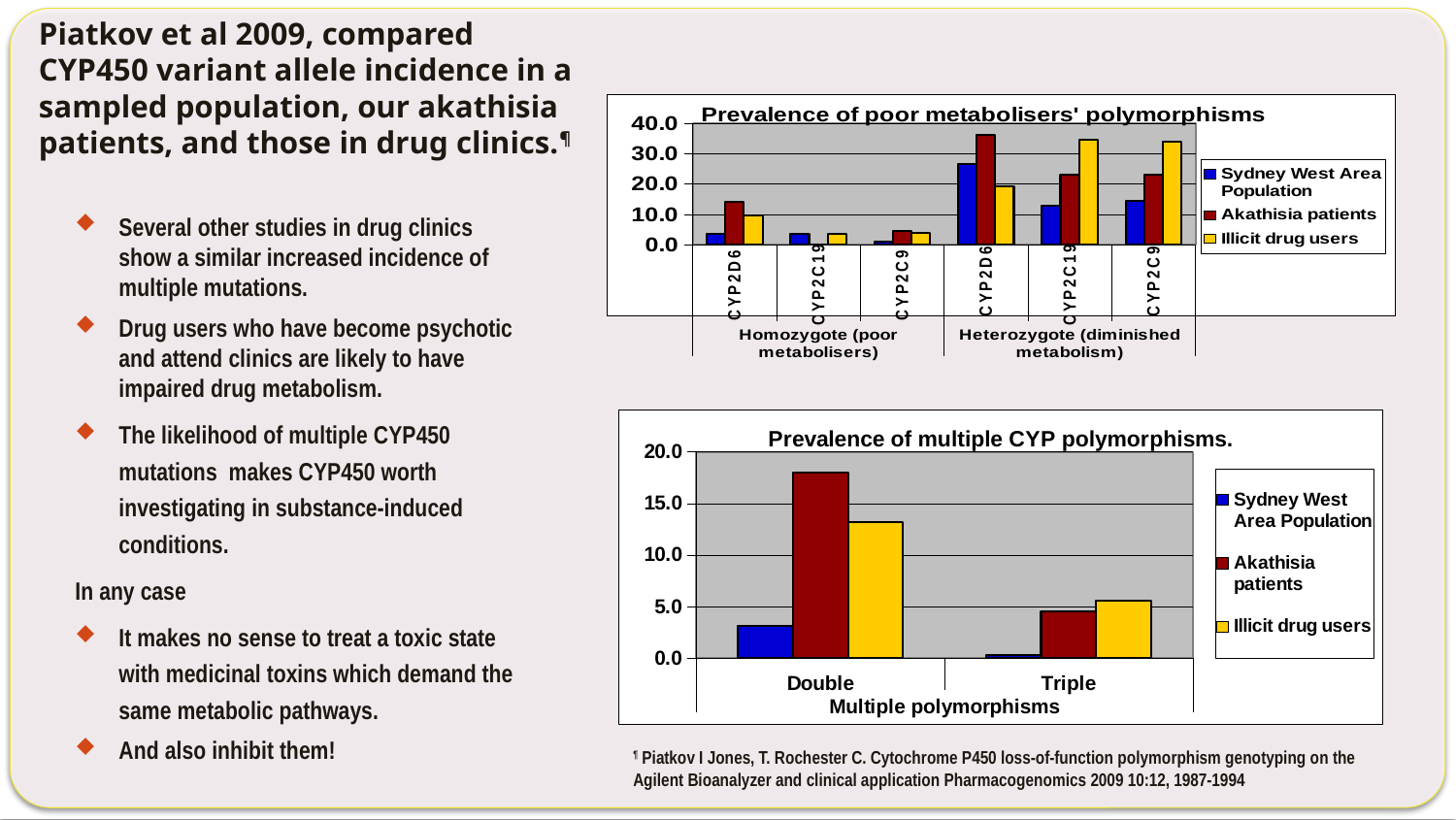
In the 'Prevalence of multiple CYP polymorphisms.' chart, is the value for Sydney West Area Population in the Double category greater or less than 5.0? less What colour represents Illicit drug users in the 'Prevalence of multiple CYP polymorphisms.' chart? yellow In the 'Prevalence of multiple CYP polymorphisms.' chart, is the Akathisia patients value larger for Double or for Triple? Double In the 'Prevalence of poor metabolisers' polymorphisms' chart, is the Sydney West Area Population value larger for Homozygote CYP2D6 or Heterozygote CYP2D6? Heterozygote CYP2D6 How many categories are shown on the x axis of the 'Prevalence of multiple CYP polymorphisms.' chart? 2 In the 'Prevalence of poor metabolisers' polymorphisms' chart, which series has the highest value for Heterozygote CYP2C19? Illicit drug users In the 'Prevalence of multiple CYP polymorphisms.' chart, is the value for Akathisia patients in the Double category greater or less than 15.0? greater In the 'Prevalence of multiple CYP polymorphisms.' chart, which series has the lowest value in the Triple category? Sydney West Area Population In the 'Prevalence of multiple CYP polymorphisms.' chart, which series has the highest value in the Double category? Akathisia patients What kind of chart is the 'Prevalence of multiple CYP polymorphisms.' chart? bar chart How many series does the legend of the 'Prevalence of poor metabolisers' polymorphisms' chart list? 3 In the 'Prevalence of poor metabolisers' polymorphisms' chart, is the value for Akathisia patients for Heterozygote CYP2D6 greater or less than 30.0? greater